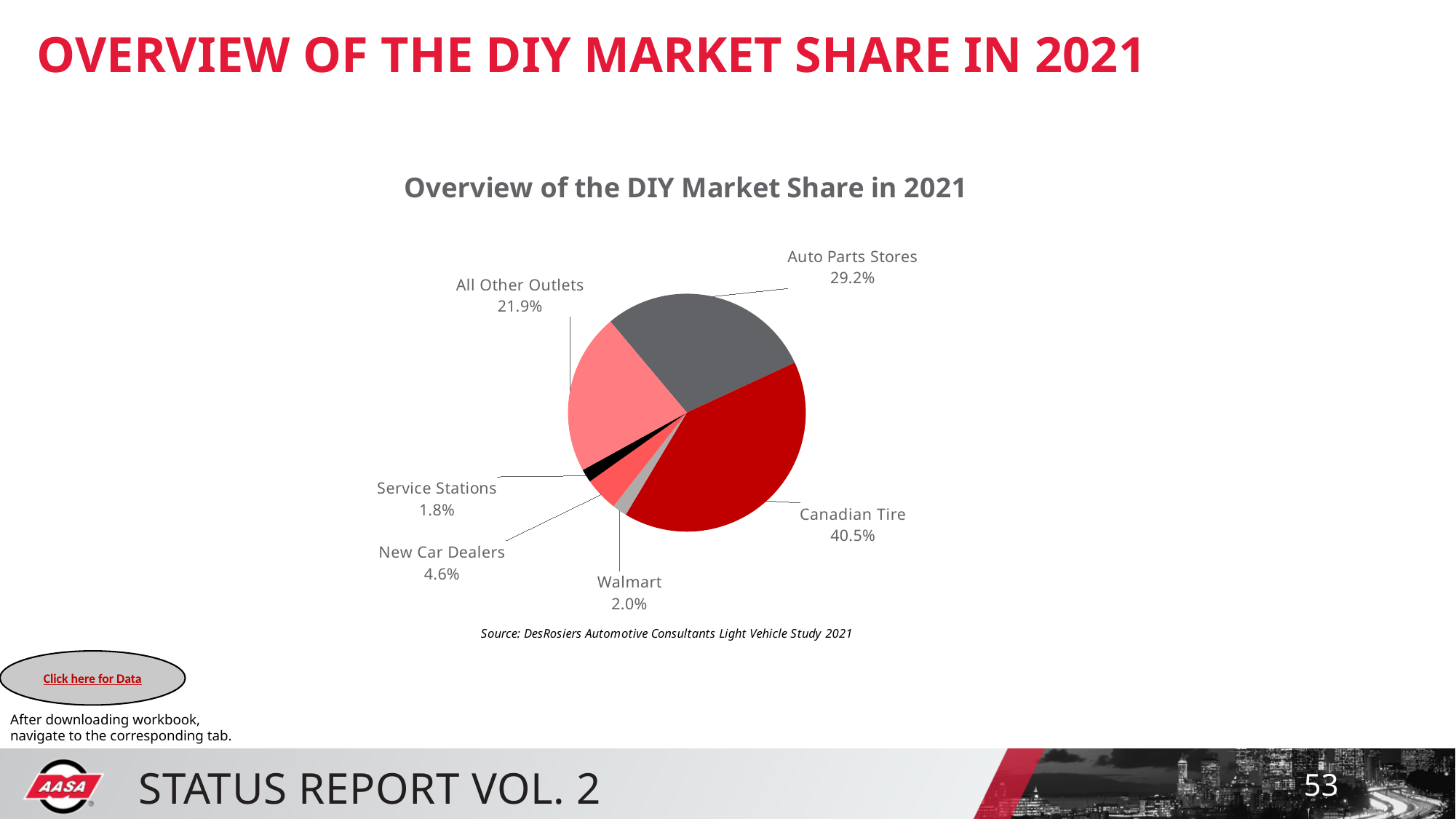
What share of the DIY market does Canadian Tire hold in the pie chart? 40.5% What is the difference between the shares of Canadian Tire and Auto Parts Stores? 11.3% Which category has the smallest slice of the pie? Service Stations What kind of chart is shown on the slide? Pie chart How many categories are shown in the pie chart? 6 Which is larger, the share for New Car Dealers or the share for Walmart? New Car Dealers What source is cited below the chart? DesRosiers Automotive Consultants Light Vehicle Study 2021 What share is shown for Walmart? 2.0% Which category has the largest slice of the pie? Canadian Tire What is the title of the chart? Overview of the DIY Market Share in 2021 What percentage is shown for All Other Outlets? 21.9% What is the value shown for Auto Parts Stores? 29.2%